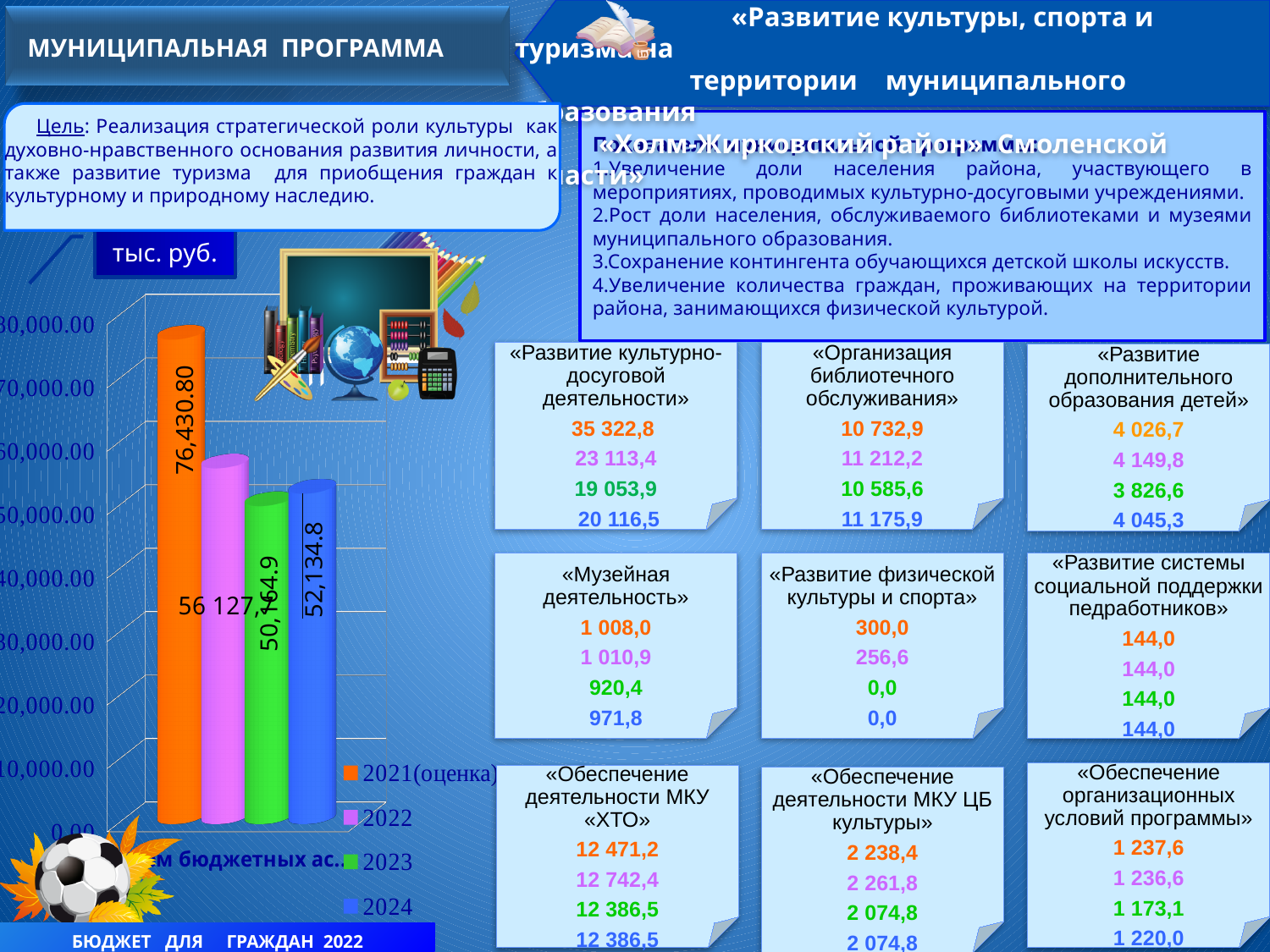
What is the difference between the 2024 value and the 2023 value in the chart? 1,969.9 Which year has the lowest bar in the chart? 2023 Is the value for 2021(оценка) in the chart greater or less than 70,000.00? greater What is the value of the 2021(оценка) bar in the chart? 76,430.80 How many series does the chart legend list? 4 Which is larger in the chart, the value for 2023 or the value for 2024? 2024 Which year has the highest bar in the chart? 2021(оценка) Do the values in the chart rise or fall from 2021(оценка) to 2023? fall What is the value of the 2024 bar in the chart? 52,134.8 Is the value for 2022 in the chart greater or less than 50,000.00? greater What kind of chart is shown on the slide? bar chart What is the value of the 2023 bar in the chart? 50,164.9